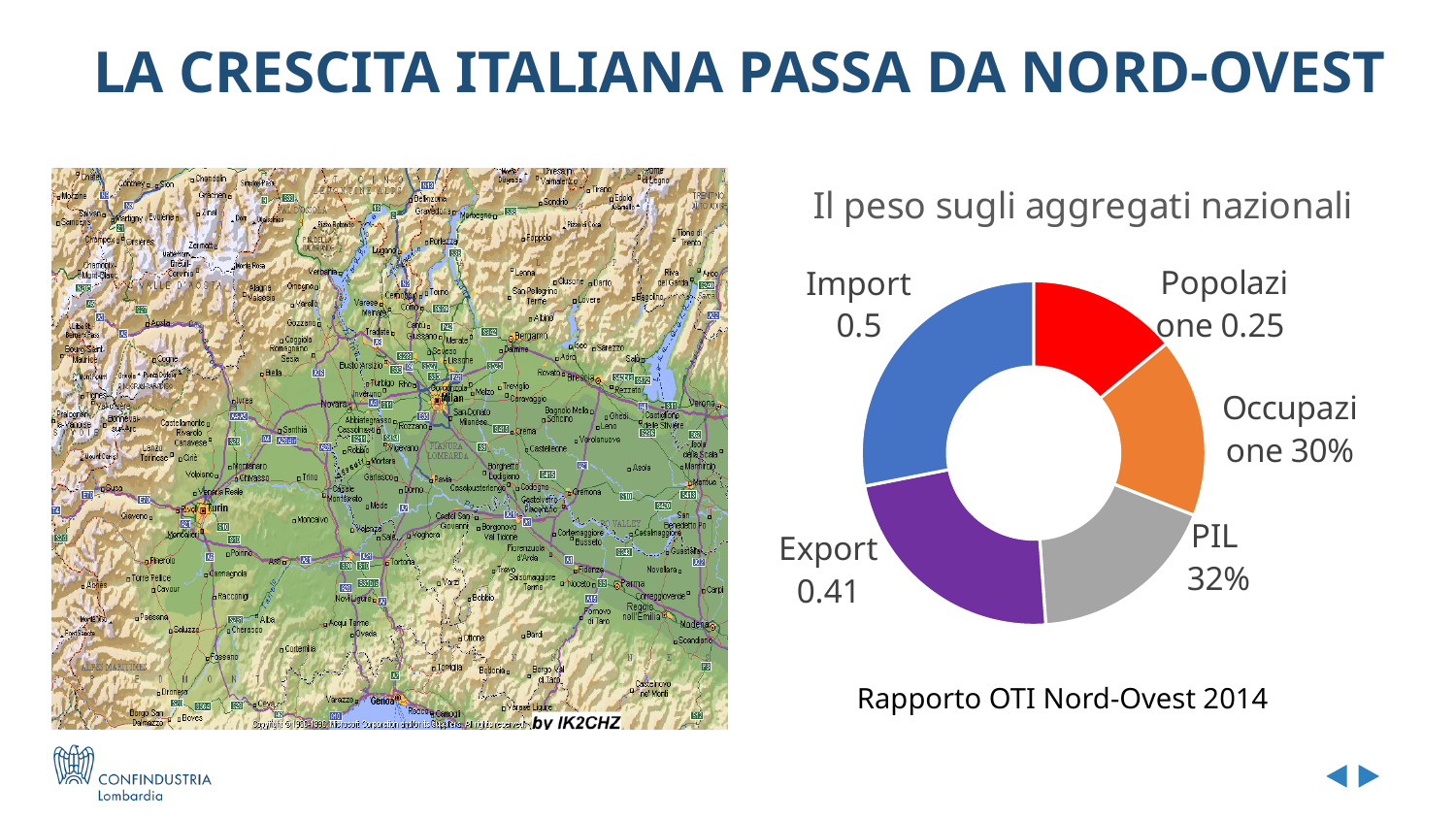
What value is shown for Occupazione in the doughnut chart? 30% What value is shown for Popolazione in the doughnut chart? 0.25 What kind of chart is shown on the slide? Doughnut chart What is the difference between the Import value and the Export value in the doughnut chart? 0.09 Which category has the largest value in the doughnut chart? Import What value is shown for Export in the doughnut chart? 0.41 How many categories are shown in the doughnut chart? 5 What value is shown for Import in the doughnut chart? 0.5 Which is larger in the doughnut chart, Import or Export? Import What is the title of the chart on the slide? Il peso sugli aggregati nazionali Which category has the smallest value in the doughnut chart? Popolazione What value is shown for PIL in the doughnut chart? 32%